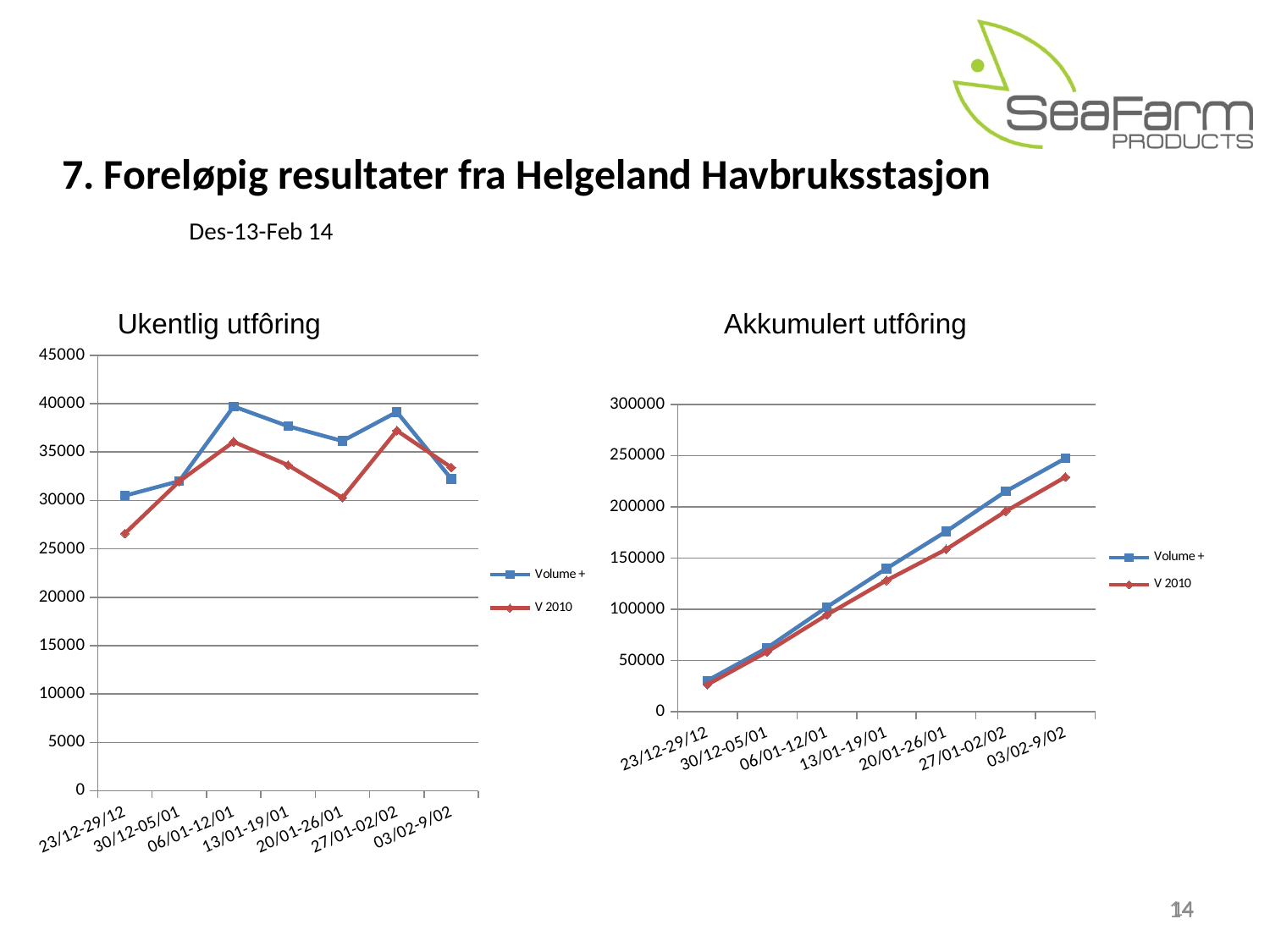
In the 'Akkumulert utfôring' chart, do the values rise or fall from left to right along the x axis? rise In the 'Ukentlig utfôring' chart, which period has the highest Volume + value? 06/01-12/01 What colour is the V 2010 line in the 'Akkumulert utfôring' chart? red How many weekly periods are plotted on the x axis of the 'Ukentlig utfôring' chart? 7 What kind of chart is the 'Ukentlig utfôring' chart? line chart In the 'Ukentlig utfôring' chart, is the Volume + value for 06/01-12/01 greater or less than 35000? greater How many series does the legend of the 'Akkumulert utfôring' chart list? 2 In the 'Akkumulert utfôring' chart, is the Volume + value for 03/02-9/02 greater or less than 200000? greater In the 'Ukentlig utfôring' chart, which period has the lowest V 2010 value? 23/12-29/12 In the 'Ukentlig utfôring' chart, which series is higher for 20/01-26/01, Volume + or V 2010? Volume + In the 'Ukentlig utfôring' chart, is the V 2010 value for 23/12-29/12 greater or less than 30000? less